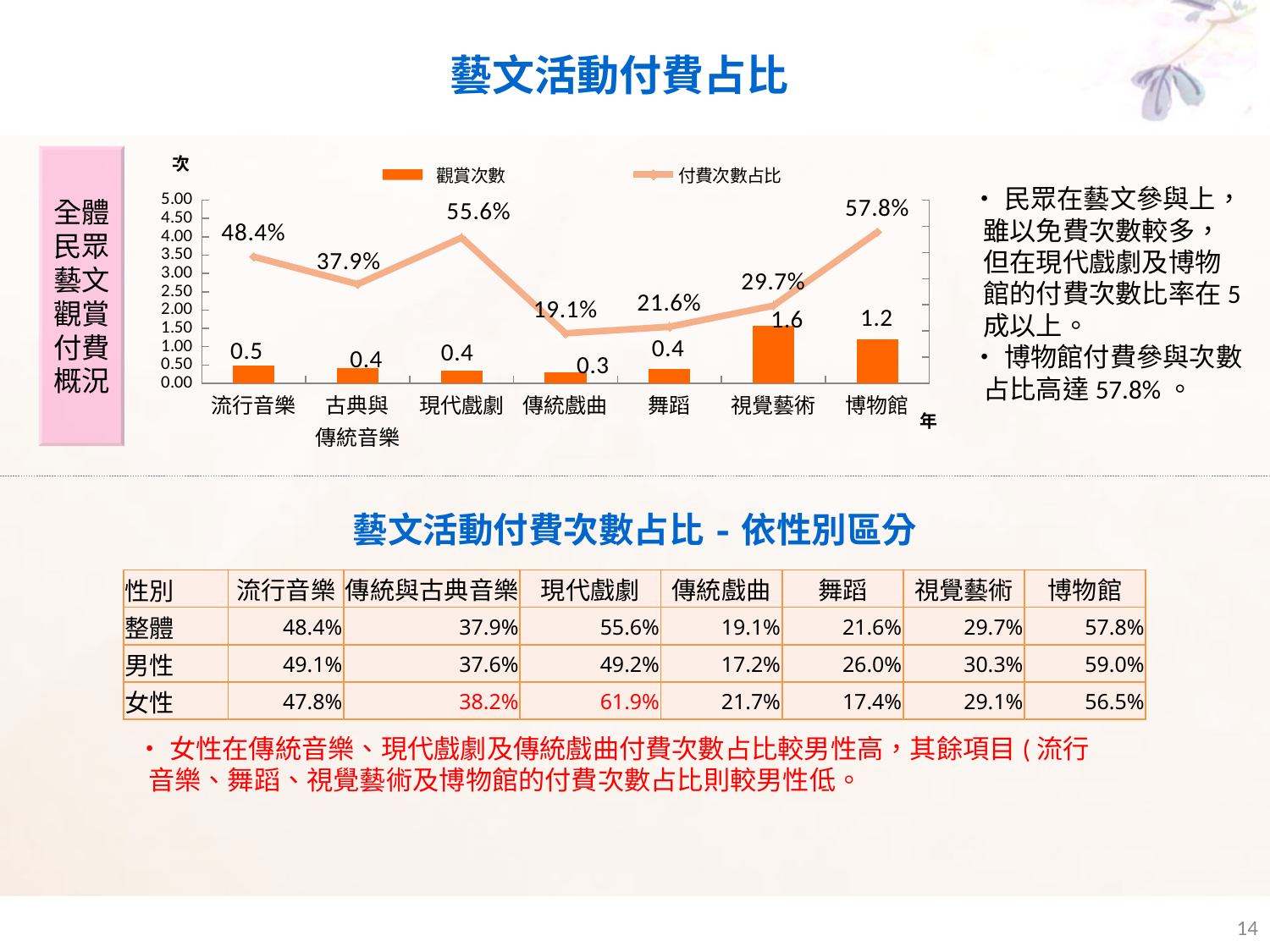
What is the difference in 付費次數占比 between 博物館 and 現代戲劇? 2.2% How many categories are shown on the x axis of the chart? 7 Which is larger, the 付費次數占比 for 流行音樂 or for 古典與傳統音樂? 流行音樂 Is the 觀賞次數 value for 視覺藝術 greater or less than 1.00? greater Which category has the lowest 付費次數占比? 傳統戲曲 Which category has the lowest 觀賞次數? 傳統戲曲 What is the 付費次數占比 value for 博物館? 57.8% What is the 付費次數占比 value for 傳統戲曲? 19.1% Which category has the highest 觀賞次數? 視覺藝術 What is the 觀賞次數 value for 視覺藝術? 1.6 What is the difference in 觀賞次數 between 視覺藝術 and 博物館? 0.4 How many series does the chart legend list? 2